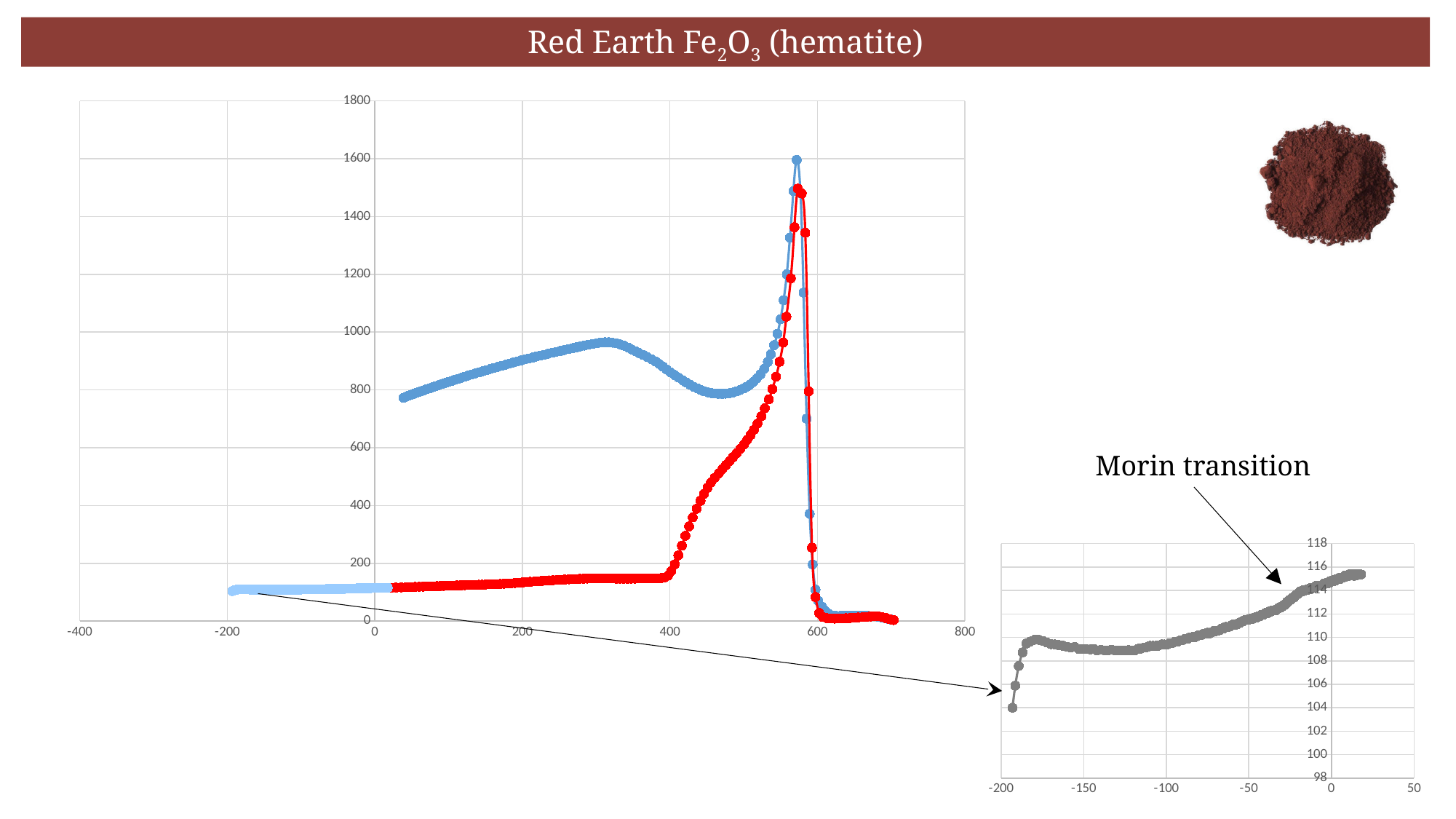
On the small inset chart at the bottom right, is the value at x = 0 greater or less than 112? greater On the small inset chart at the bottom right, is the value at x = -200 greater or less than 106? less On the large chart on the left, is the value of the light blue series at x = -100 greater or less than 200? less On the large chart on the left, which series reaches the higher peak, the blue series or the red series? blue What is the highest tick shown on the y axis of the large chart on the left? 1800 On the small inset chart at the bottom right, do the values rise or fall as x goes from -150 to 0? rise What annotation label points to the small inset chart at the bottom right? Morin transition What kind of chart is the large chart on the left of the slide? scatter chart